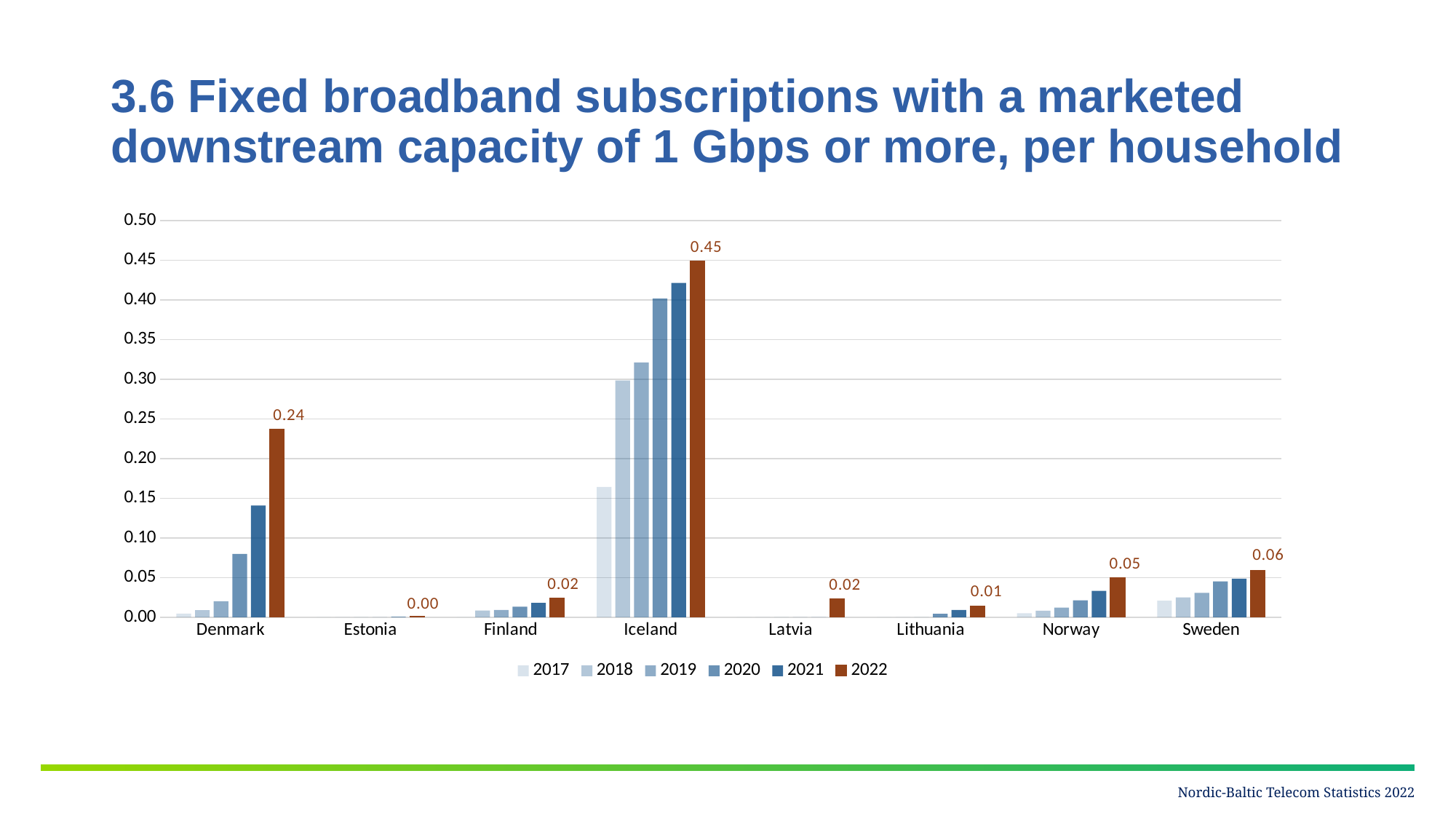
Is the 2021 value for Iceland greater or less than 0.40? greater How many series does the legend list? 6 What is the difference between the 2022 values for Iceland and Denmark? 0.21 Which country has the highest 2022 value? Iceland What is the 2022 value for Iceland? 0.45 How many countries are shown on the x axis? 8 What kind of chart is shown on the slide? Bar chart What is the 2022 value for Denmark? 0.24 What is the 2022 value for Sweden? 0.06 Which country has the lowest 2022 value? Estonia What is the 2022 value for Estonia? 0.00 Which has the larger 2022 value, Norway or Sweden? Sweden